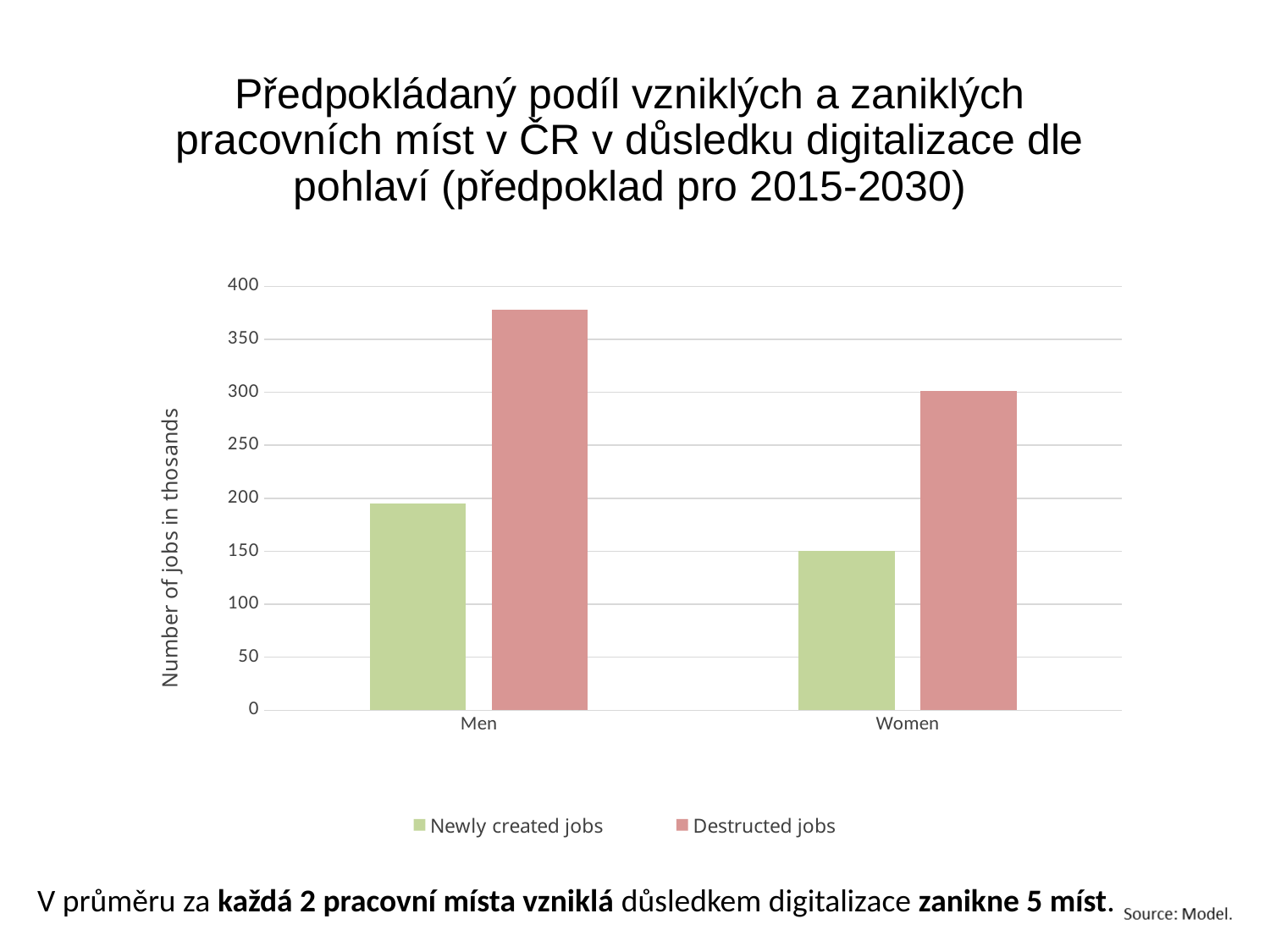
Is the value for Destructed jobs for Men greater or less than 350? greater How many series does the legend list? 2 How many categories are shown on the x axis? 2 Which category has the higher value for Destructed jobs? Men Is the value for Newly created jobs for Women greater or less than 100? greater What kind of chart is shown on the slide? bar chart Which bar is the lowest in the chart? Newly created jobs for Women Which is larger: Newly created jobs for Men or Newly created jobs for Women? Men For Women, which series has the larger value: Newly created jobs or Destructed jobs? Destructed jobs Is the value for Destructed jobs for Women greater or less than 250? greater What is the label of the vertical axis? Number of jobs in thosands